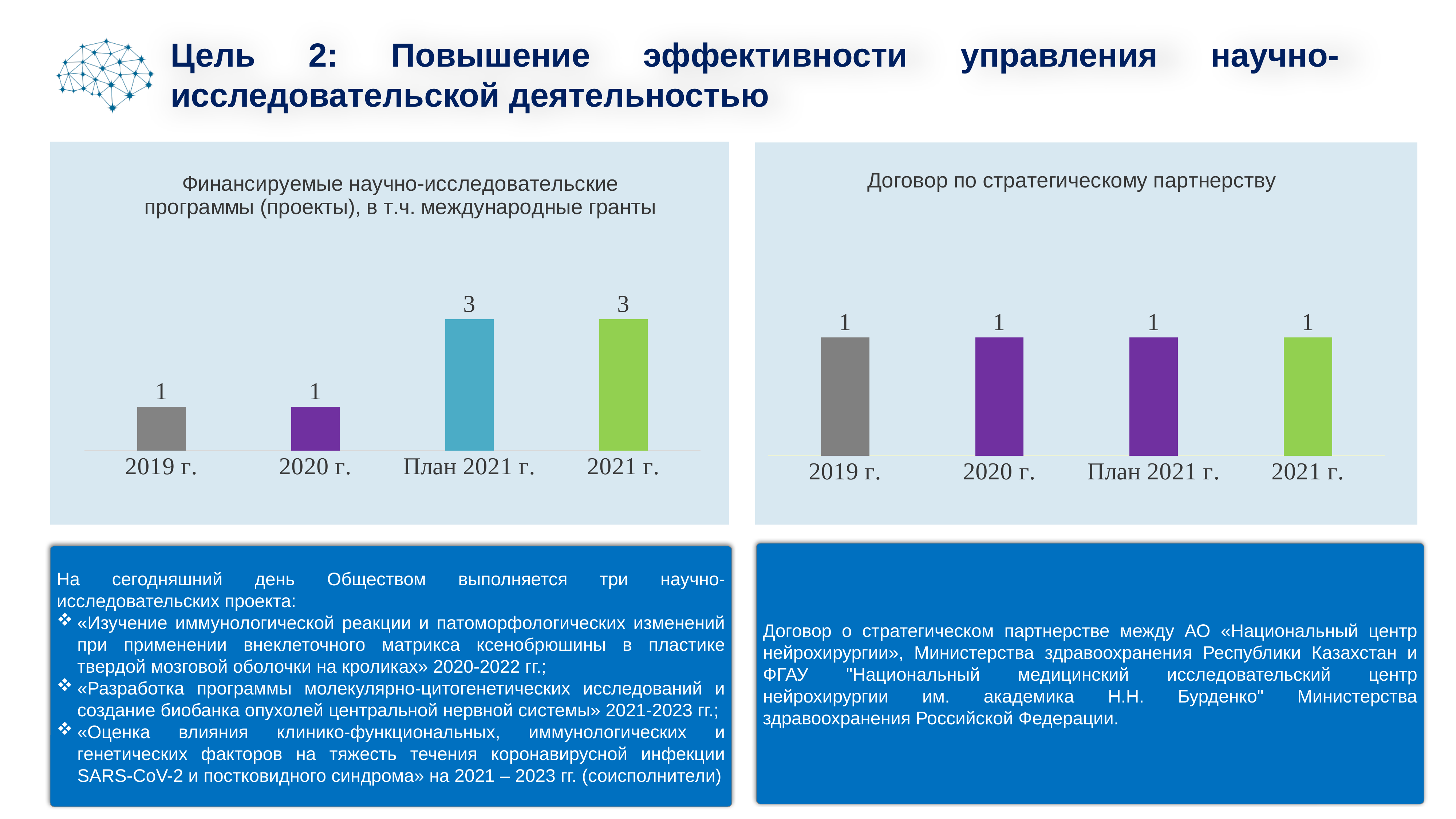
In the left chart (Финансируемые научно-исследовательские программы), which is larger, the value for 2020 г. or the value for План 2021 г.? План 2021 г. In the right chart (Договор по стратегическому партнерству), what is the value for 2021 г.? 1 In the left chart (Финансируемые научно-исследовательские программы), what is the value for 2019 г.? 1 In the left chart (Финансируемые научно-исследовательские программы), how many categories are shown on the x axis? 4 In the left chart (Финансируемые научно-исследовательские программы), what is the difference between the values for 2021 г. and 2020 г.? 2 What kind of chart is the right chart (Договор по стратегическому партнерству)? bar chart In the left chart (Финансируемые научно-исследовательские программы), what is the value for План 2021 г.? 3 In the left chart (Финансируемые научно-исследовательские программы), what is the value for 2021 г.? 3 What is the title of the right chart on the slide? Договор по стратегическому партнерству In the right chart (Договор по стратегическому партнерству), what is the value for 2020 г.? 1 In the right chart (Договор по стратегическому партнерству), how many bars are shown? 4 In the left chart (Финансируемые научно-исследовательские программы), do the values rise or fall from 2019 г. to 2021 г.? rise